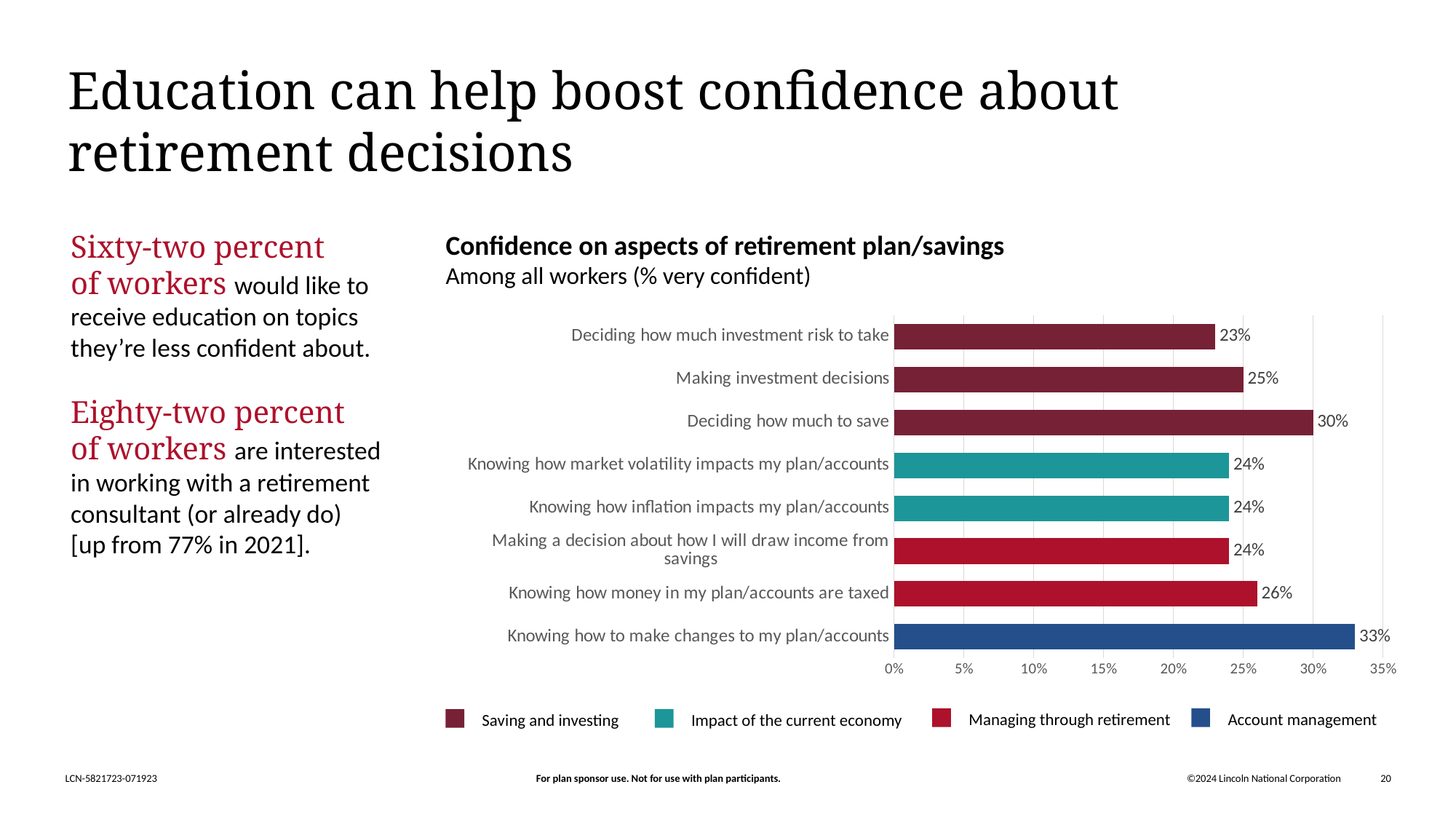
How many series does the legend list? 4 Which category has the lowest percentage of very confident workers? Deciding how much investment risk to take What is the difference between 'Knowing how to make changes to my plan/accounts' and 'Making investment decisions'? 8% How many categories are shown in the chart? 8 What percentage of workers are very confident about deciding how much to save? 30% What is the title of the chart? Confidence on aspects of retirement plan/savings Which legend series does the bar for 'Knowing how to make changes to my plan/accounts' belong to? Account management What is the value for 'Deciding how much investment risk to take'? 23% What is the value for 'Knowing how money in my plan/accounts are taxed'? 26% Which category has the highest percentage of very confident workers? Knowing how to make changes to my plan/accounts What kind of chart is shown on the slide? Bar chart Which is larger: the value for 'Deciding how much to save' or the value for 'Knowing how money in my plan/accounts are taxed'? Deciding how much to save